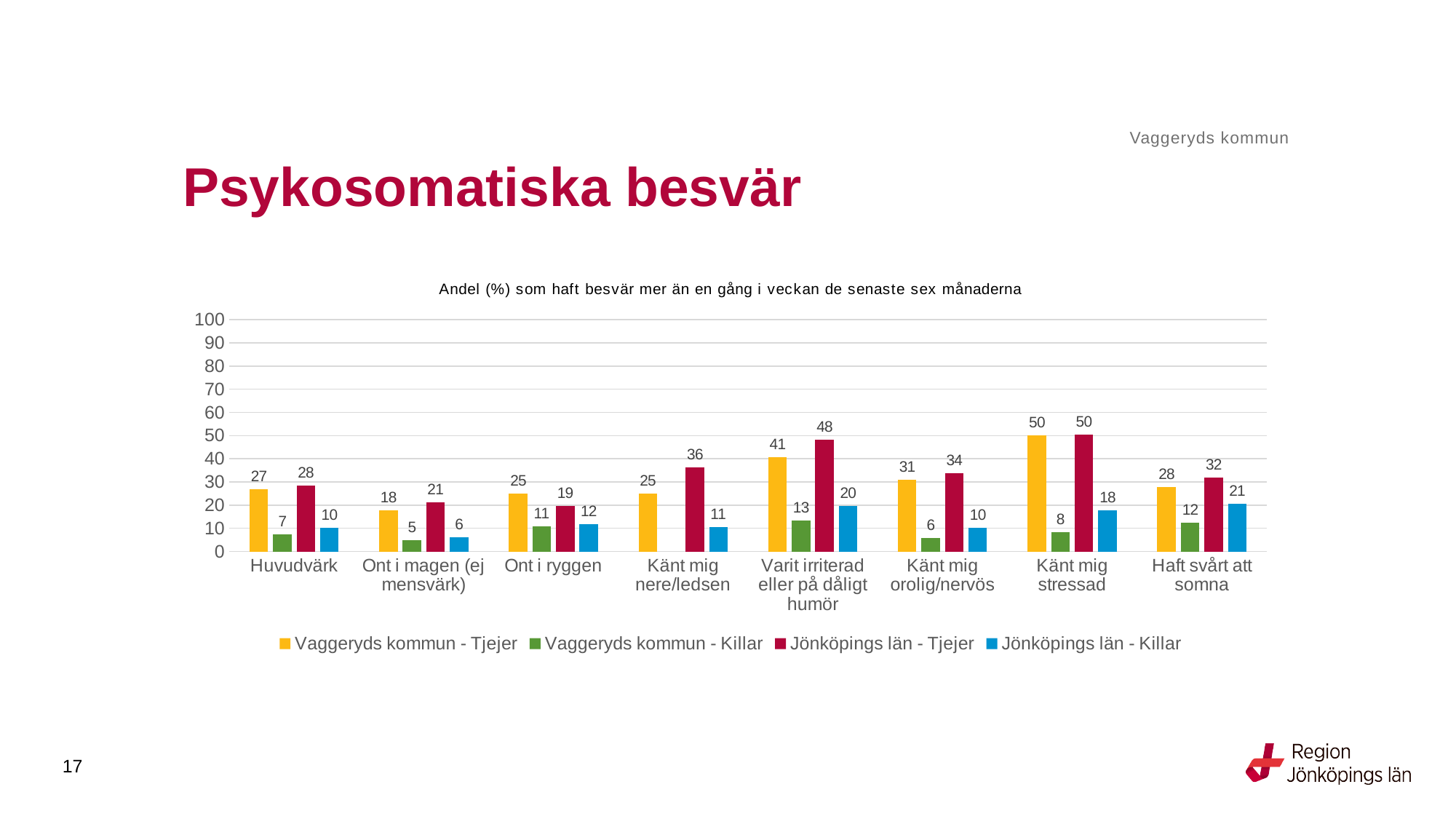
What is the value for Vaggeryds kommun - Tjejer in the category Känt mig stressad? 50 Which category has the highest value for Jönköpings län - Tjejer? Känt mig stressad Is the value for Jönköpings län - Tjejer in the category Känt mig nere/ledsen greater or less than 30? greater How many series does the legend list? 4 In the category Varit irriterad eller på dåligt humör, how much higher is Jönköpings län - Tjejer than Vaggeryds kommun - Tjejer? 7 What is the title of the chart? Andel (%) som haft besvär mer än en gång i veckan de senaste sex månaderna In the category Ont i ryggen, which is larger: Vaggeryds kommun - Tjejer or Jönköpings län - Tjejer? Vaggeryds kommun - Tjejer What is the value for Jönköpings län - Killar in the category Haft svårt att somna? 21 What is the value for Vaggeryds kommun - Killar in the category Varit irriterad eller på dåligt humör? 13 Which category has the lowest value for Vaggeryds kommun - Killar? Ont i magen (ej mensvärk) What kind of chart is shown on the slide? bar chart How many categories are shown on the x axis of the chart? 8